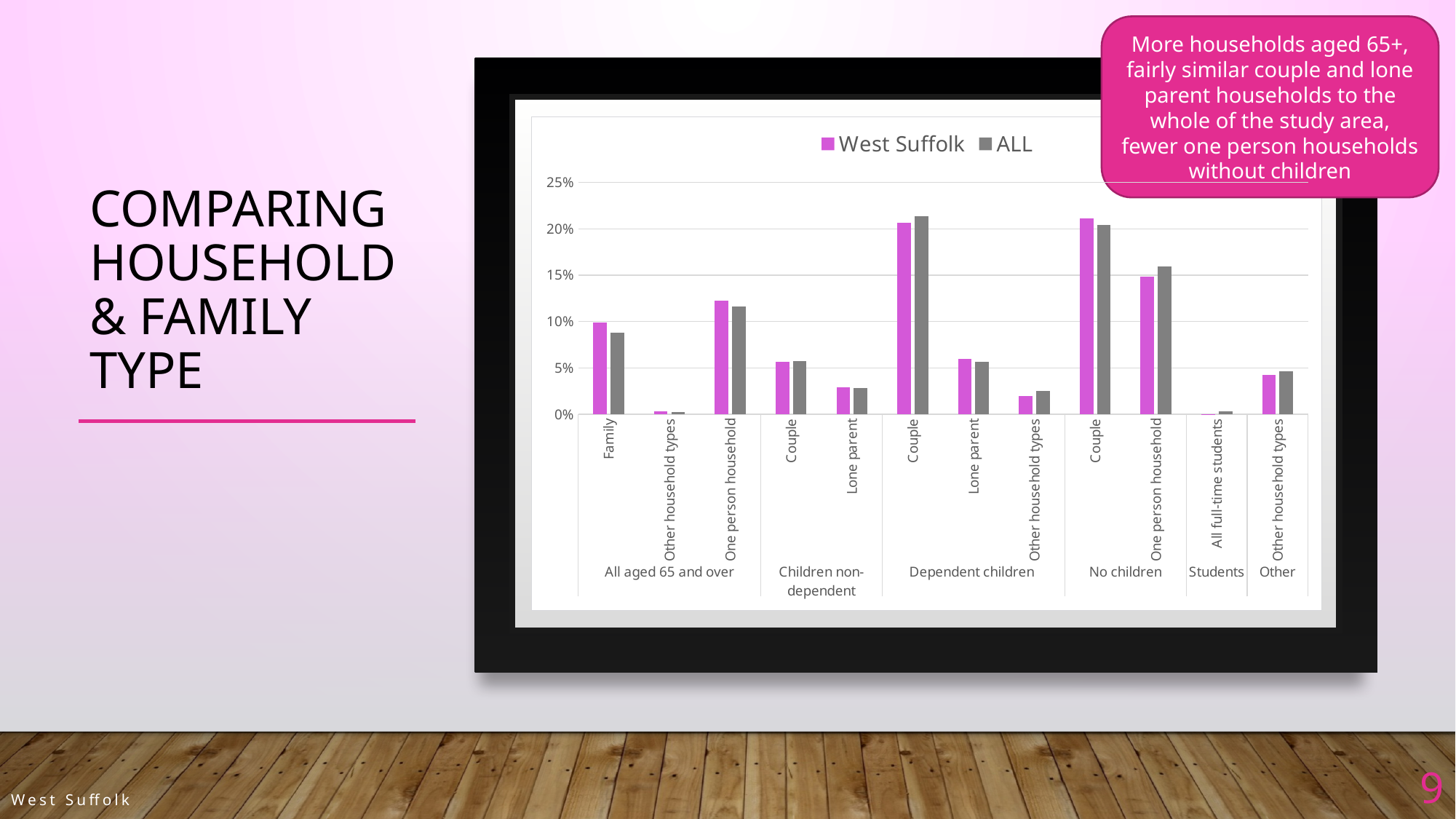
For One person household under 'No children', which series has the larger value, West Suffolk or ALL? ALL What are the two series named in the chart legend? West Suffolk and ALL How many series does the chart legend list? 2 Is the ALL value for One person household under 'No children' greater or less than 15%? greater How many household-type categories are plotted along the x axis? 12 Is the West Suffolk value for One person household under 'All aged 65 and over' greater or less than 10%? greater Which category has the lowest West Suffolk value? All full-time students Is the ALL value for Other household types under 'Dependent children' greater or less than 5%? less What kind of chart is shown on the slide? Bar chart For Family under 'All aged 65 and over', which series has the larger value, West Suffolk or ALL? West Suffolk Which colour represents the West Suffolk series in the chart? Pink